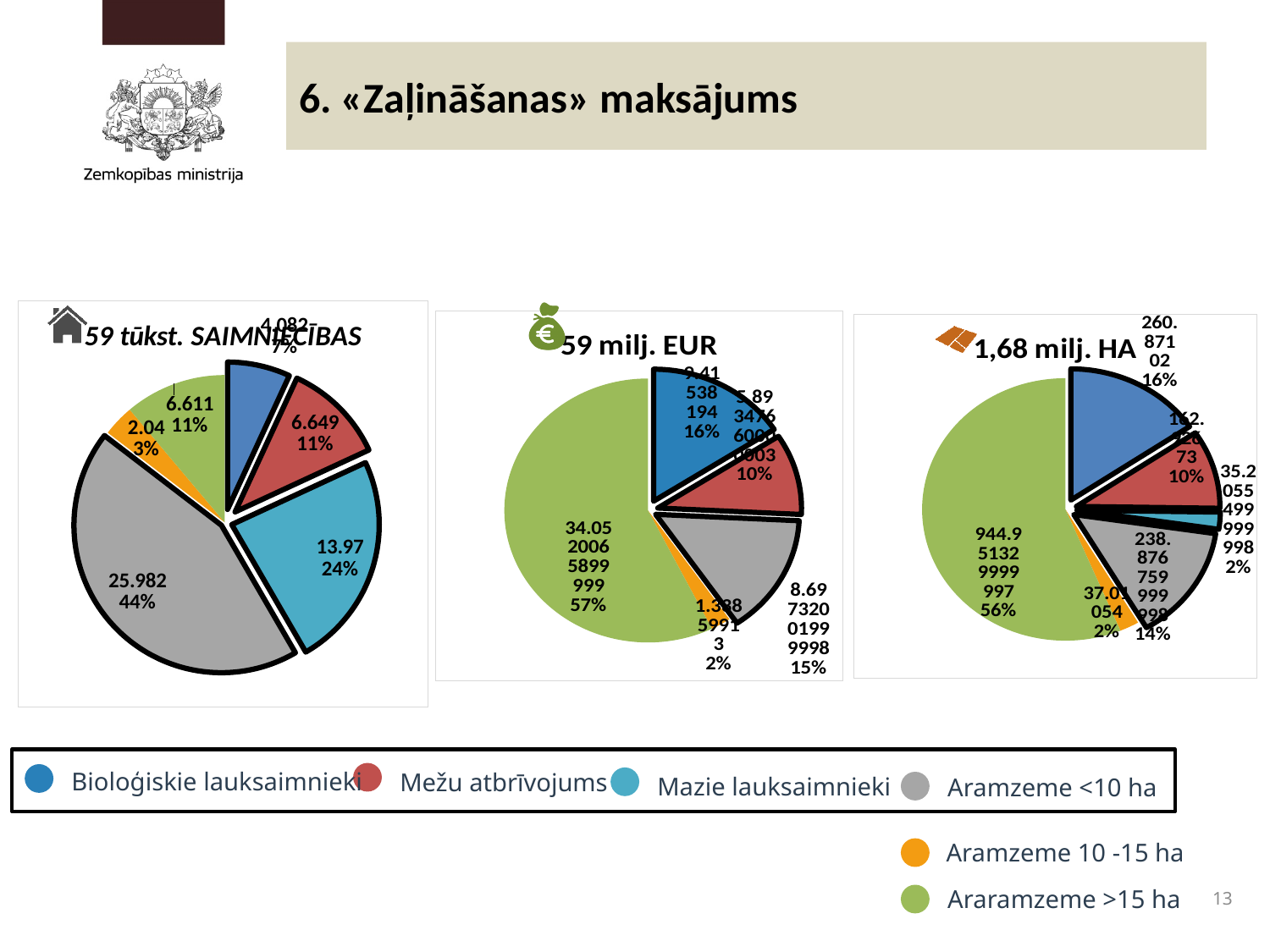
In the chart titled '59 tūkst. SAIMNIECĪBAS', what value is shown for Mazie lauksaimnieki? 13.97 How many categories does the shared legend list? 6 In the chart titled '59 tūkst. SAIMNIECĪBAS', what share of the pie is Aramzeme <10 ha? 44% In the chart titled '59 milj. EUR', what share of the pie is Araramzeme >15 ha? 57% In the chart titled '59 milj. EUR', what share of the pie is Aramzeme <10 ha? 15% In the chart titled '1,68 milj. HA', which is larger, the slice for Bioloģiskie lauksaimnieki or the slice for Mežu atbrīvojums? Bioloģiskie lauksaimnieki What kind of chart is used for '59 milj. EUR'? Pie chart In the chart titled '59 tūkst. SAIMNIECĪBAS', which category has the largest slice? Aramzeme <10 ha In the chart titled '59 tūkst. SAIMNIECĪBAS', which category has the smallest slice? Aramzeme 10 -15 ha In the chart titled '59 tūkst. SAIMNIECĪBAS', what value is shown for Aramzeme <10 ha? 25.982